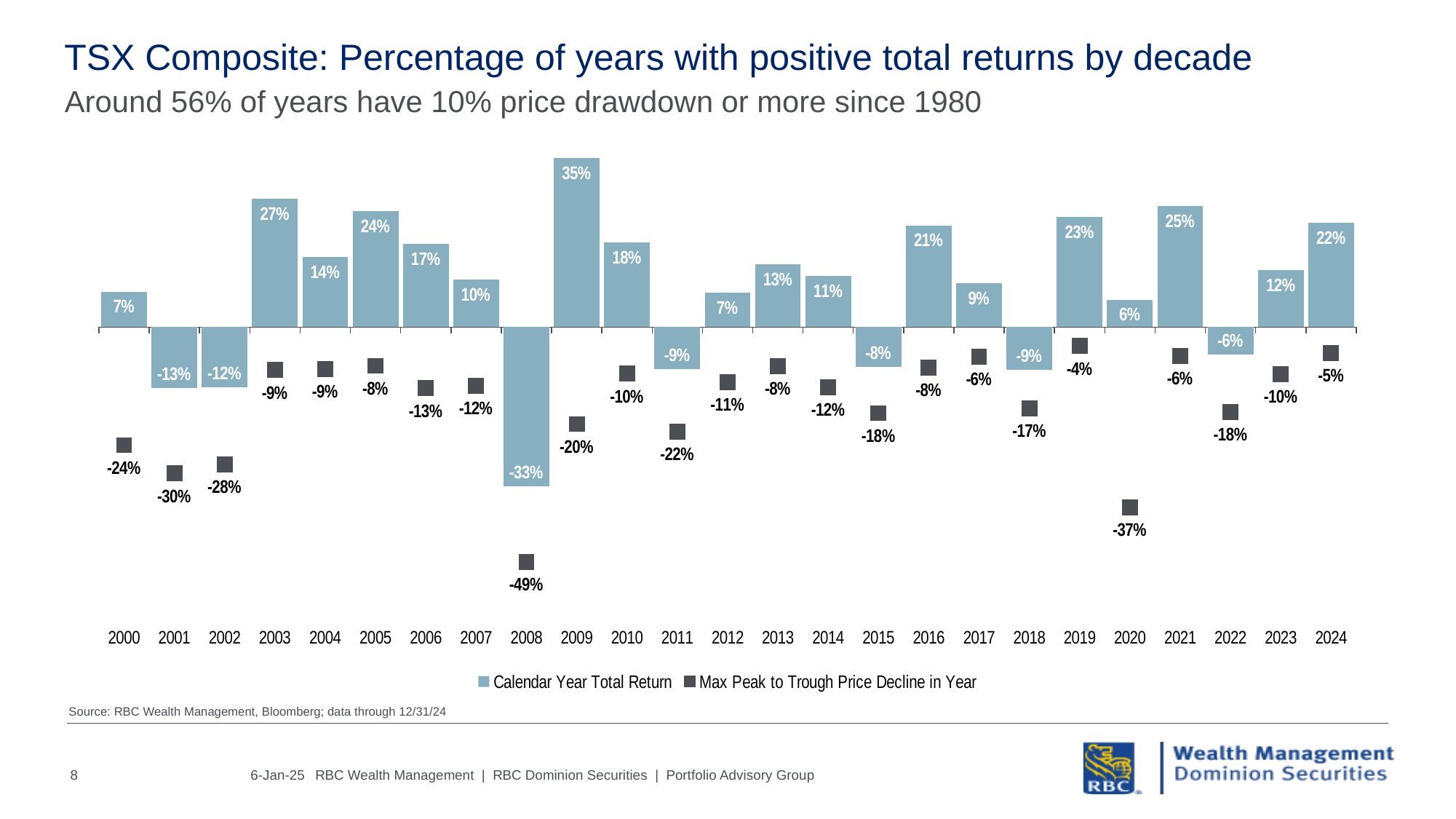
What is the difference between the Calendar Year Total Return for 2021 and for 2020? 19 percentage points What is the Max Peak to Trough Price Decline in Year for 2019? -4% Which year had the lowest Calendar Year Total Return? 2008 How many series does the legend list? 2 What kind of chart is used to show the Calendar Year Total Return? Bar chart What was the Calendar Year Total Return for 2009? 35% What was the Calendar Year Total Return for 2024? 22% What was the Max Peak to Trough Price Decline in Year for 2020? -37% How many years are shown on the x axis of the chart? 25 Which year had a higher Calendar Year Total Return, 2003 or 2005? 2003 Which year had the highest Calendar Year Total Return? 2009 Which year had the largest Max Peak to Trough Price Decline in Year? 2008